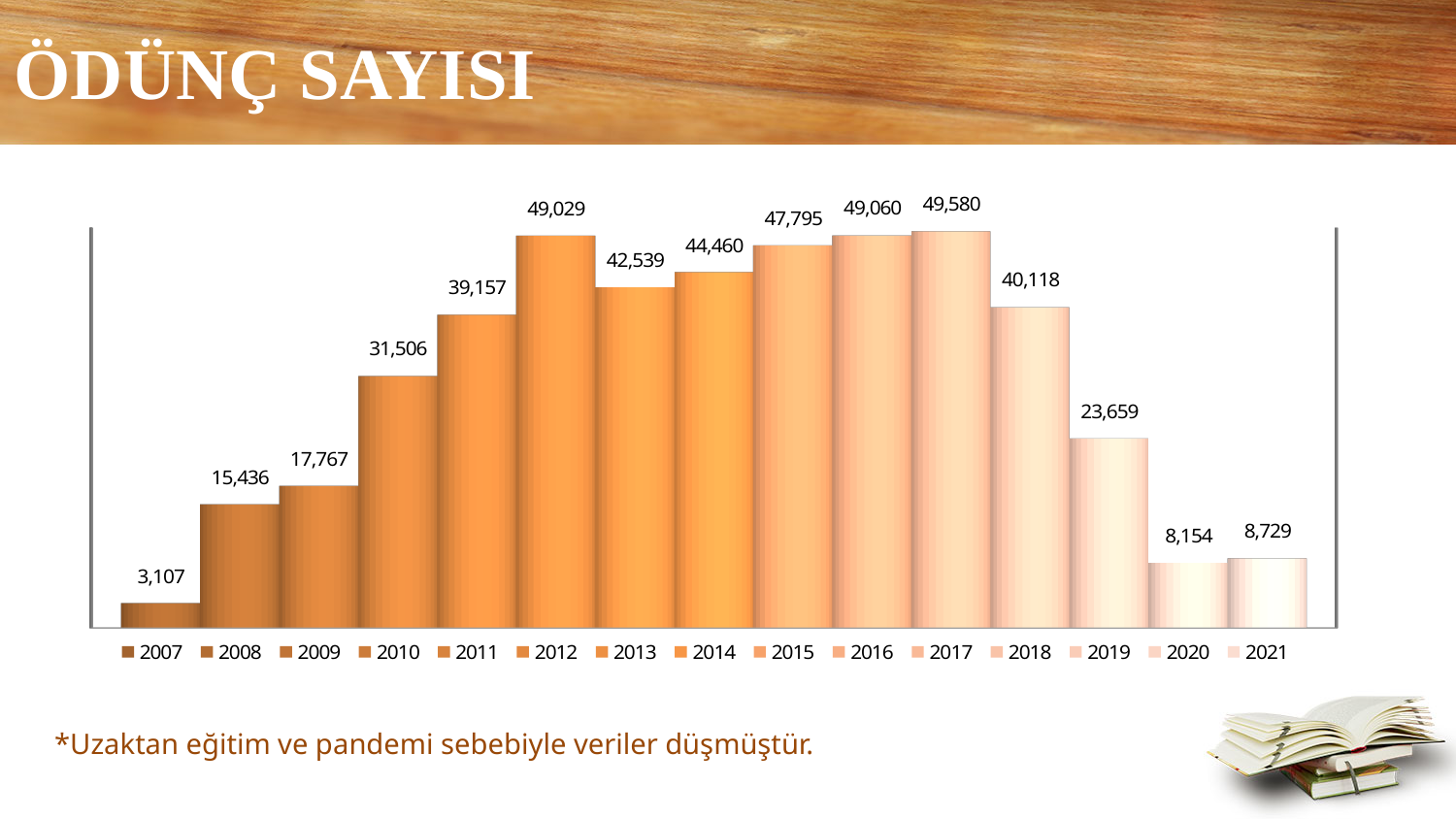
Which year has the lowest value? 2007 What is the difference between the values for 2017 and 2016? 520 What is the value for 2007? 3,107 Which year has the highest value? 2017 What kind of chart is shown on the slide? bar chart How many bars are plotted in the chart? 15 Which is larger, the value for 2013 or the value for 2014? 2014 What is the difference between the values for 2018 and 2019? 16,459 What is the value for 2012? 49,029 How many entries does the legend list? 15 What is the value for 2019? 23,659 Which is larger, the value for 2020 or the value for 2021? 2021